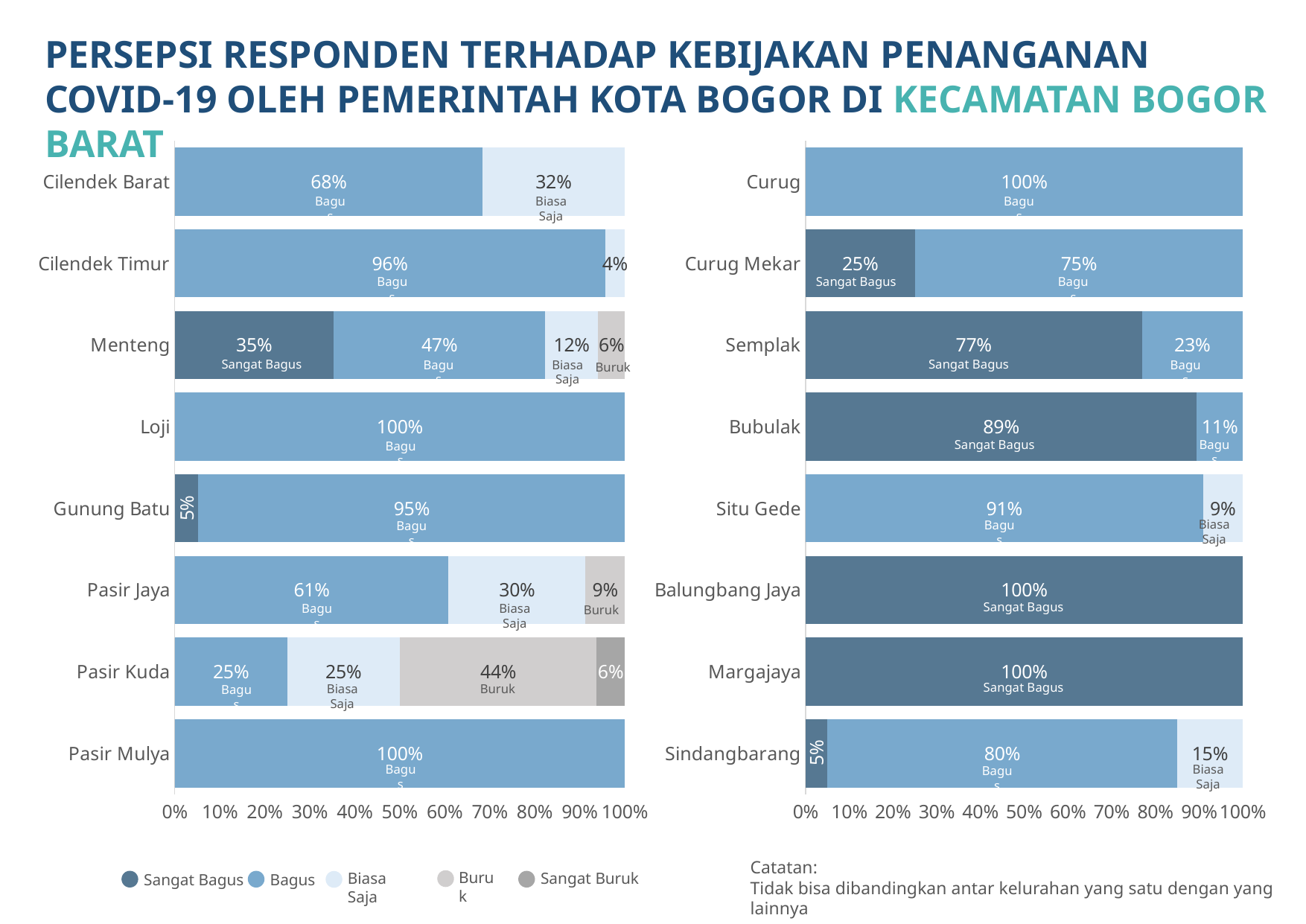
What type of chart is used on this slide? Stacked bar chart In the right chart, which kelurahan has the lowest Sangat Bagus share among Curug Mekar, Semplak and Bubulak? Curug Mekar In the left chart, what percentage of respondents in Menteng rated the policy Sangat Bagus? 35% How many kelurahan are shown in the left chart? 8 In the right chart, what percentage of respondents in Semplak rated the policy Sangat Bagus? 77% How many categories does the legend list? 5 In the left chart, what is the difference between the Bagus share of Cilendek Timur and the Bagus share of Cilendek Barat? 28% In the left chart, which kelurahan has the highest Buruk share? Pasir Kuda In the right chart, what is the Biasa Saja share for Sindangbarang? 15% In the right chart, what is the total of the Sangat Bagus and Bagus shares for Bubulak? 100% In the right chart, which is larger: the Bagus share for Situ Gede or the Bagus share for Sindangbarang? Situ Gede In the left chart, what is the Buruk share for Pasir Kuda? 44%